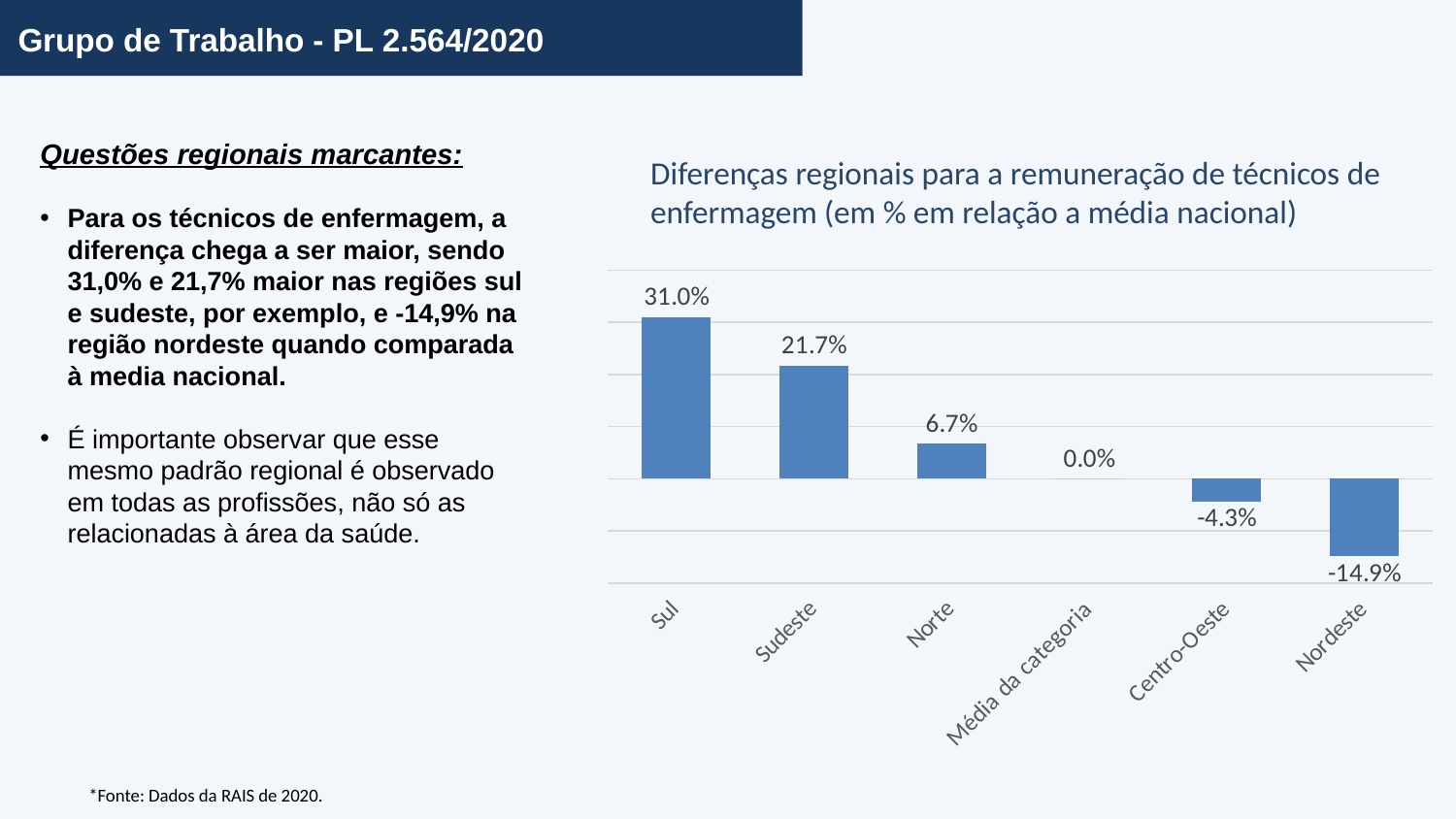
Which is larger, the value for Norte or the value for Centro-Oeste? Norte What is the value for Sudeste? 21.7% What is the value for Norte? 6.7% Which category has the lowest value? Nordeste What is the difference between the values for Sul and Sudeste? 9.3% Which category has the highest value? Sul What is the value for Nordeste? -14.9% What is the value for Sul? 31.0% How many categories are shown on the x axis? 6 Do the values rise or fall from left to right along the x axis? Fall What kind of chart is shown on the slide? Bar chart What is the value for Centro-Oeste? -4.3%